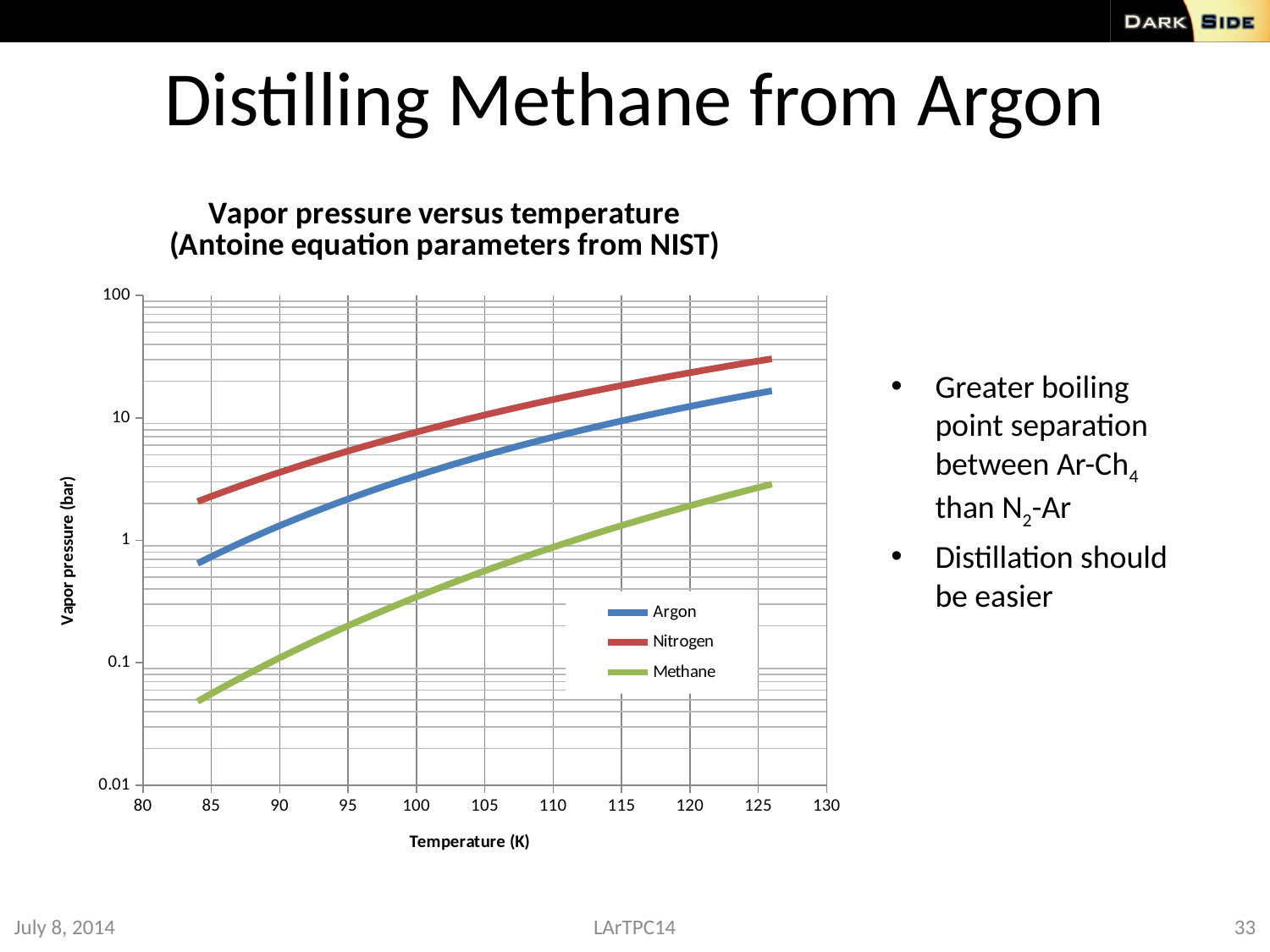
What is the title of the chart? Vapor pressure versus temperature (Antoine equation parameters from NIST) What kind of chart is shown on the slide? line chart Is the vapor pressure of Argon at 85 K greater or less than 1 bar? less How many series does the chart's legend list? 3 Which series are listed in the chart's legend? Argon, Nitrogen, Methane Does the vapor pressure of Argon rise or fall as temperature increases along the x axis? rise Which series has the highest vapor pressure across the plotted temperature range? Nitrogen Is the vapor pressure of Methane at 85 K greater or less than 0.1 bar? less Is the vapor pressure of Nitrogen at 125 K greater or less than 10 bar? greater At 100 K, which has the higher vapor pressure, Argon or Methane? Argon Which series has the lowest vapor pressure across the plotted temperature range? Methane